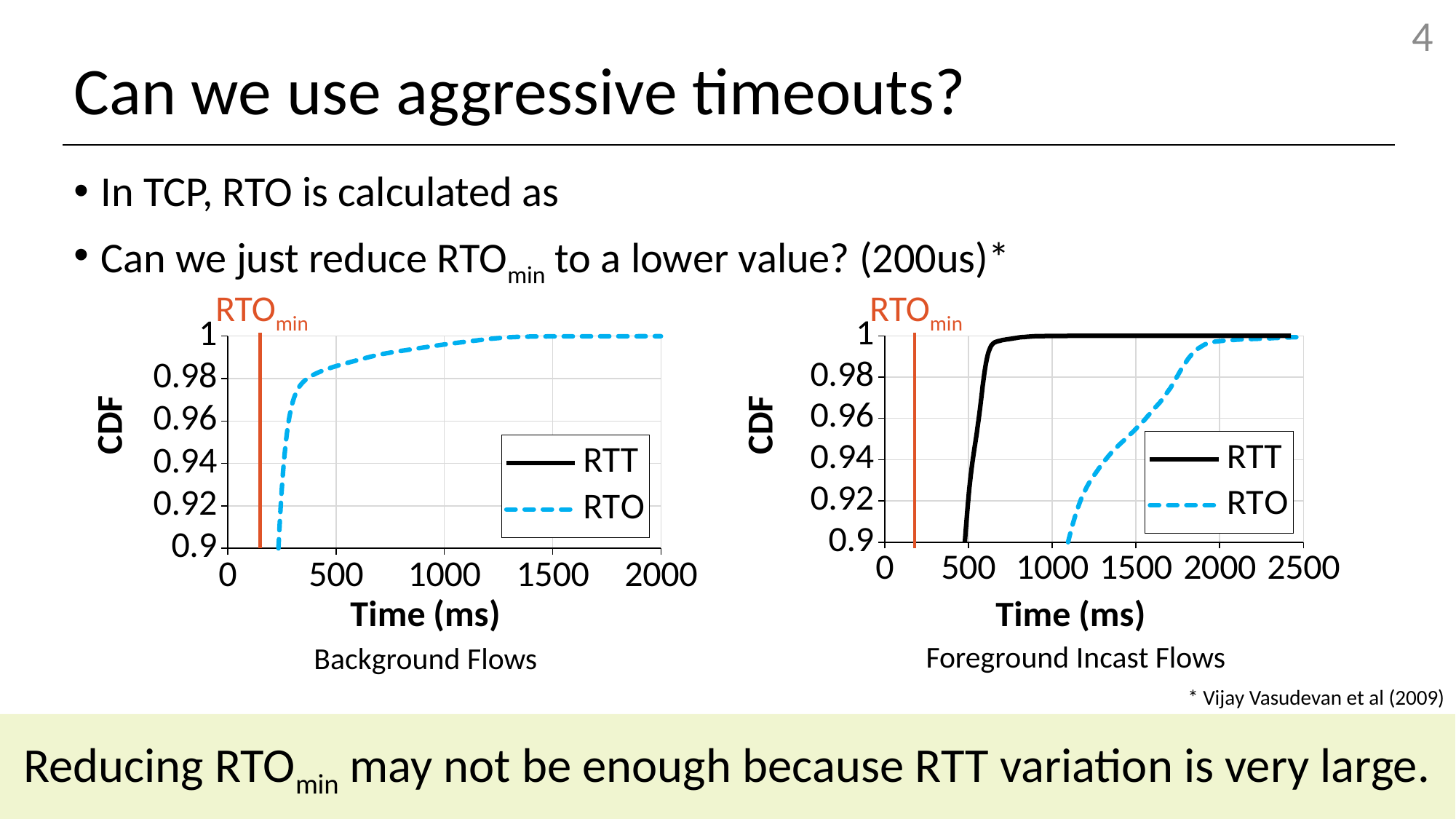
In the Foreground Incast Flows chart, does the RTO curve rise or fall as time increases? rise What kind of chart is the Background Flows chart? line chart In the Background Flows chart, is the time at which the RTO curve reaches a CDF of 0.98 greater or less than 500 ms? less In the Foreground Incast Flows chart, is the time at which the RTT curve reaches a CDF of 1 greater or less than 1000 ms? less What are the two series named in the legend of the Background Flows chart? RTT and RTO In the Foreground Incast Flows chart, which series reaches a CDF of 1 at a smaller time, RTT or RTO? RTT What is the largest tick value on the x axis of the Background Flows chart? 2000 In the Foreground Incast Flows chart, is the time at which the RTO curve reaches a CDF of 0.9 greater or less than 1000 ms? greater What is the lowest tick value on the y axis of the Background Flows chart? 0.9 How many series does the legend of the Foreground Incast Flows chart list? 2 What is the largest tick value on the x axis of the Foreground Incast Flows chart? 2500 What is the x-axis label of the Foreground Incast Flows chart? Time (ms)